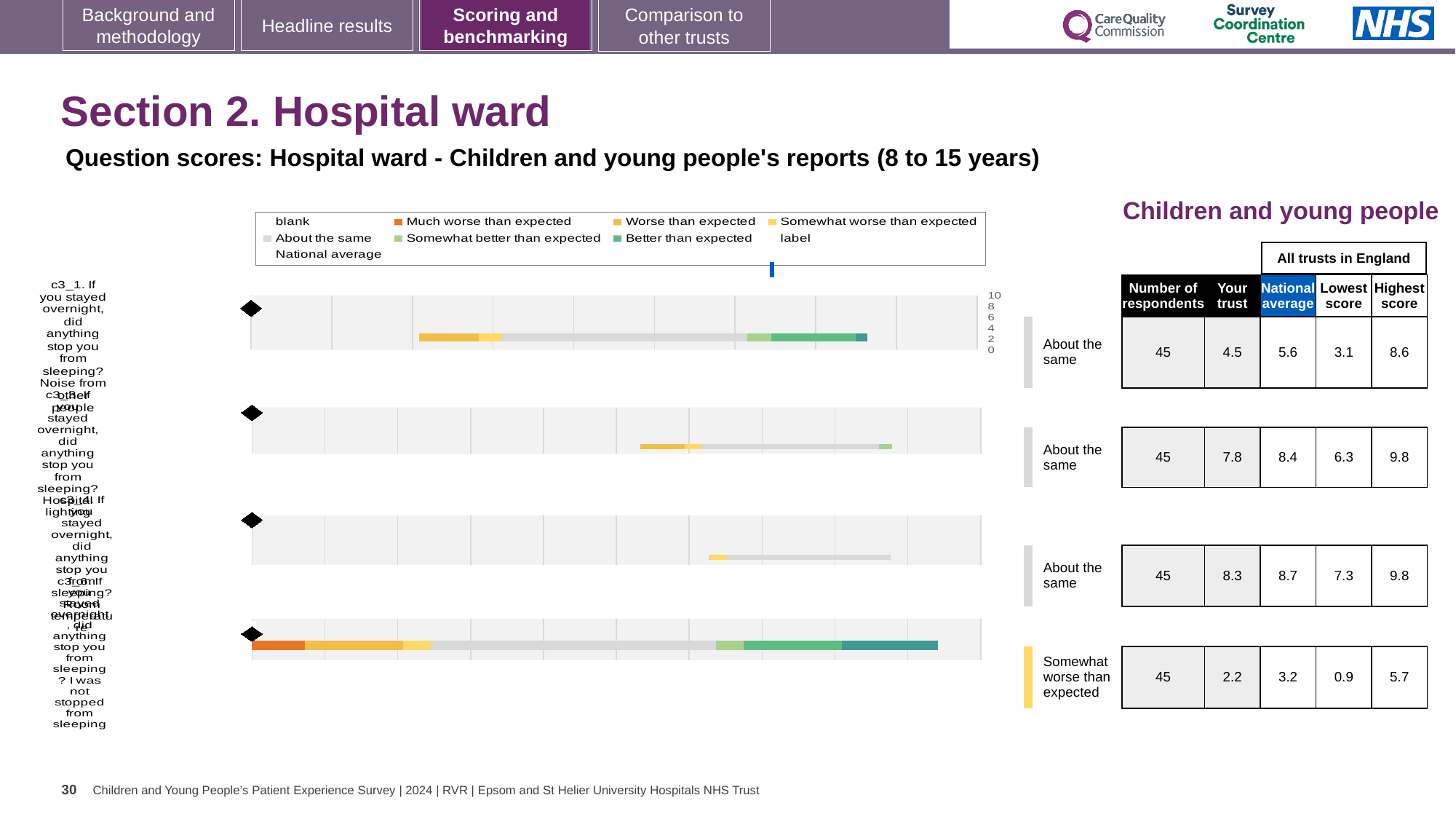
For the first (top) question row, how much higher is the national average than the 'Your trust' score? 1.1 Which question row has the highest 'Your trust' score? The third row (8.3) Which question row has the lowest 'Your trust' score? The fourth row (2.2) What colour represents 'Much worse than expected' in the legend? Orange What is the 'Your trust' score for the first (top) question row? 4.5 How many horizontal bars (question rows) does the chart show? 4 What kind of chart is shown on the slide? Bar chart How many entries does the chart legend list? 9 What is the national average for the fourth (bottom) question row? 3.2 What is the highest score across all trusts in England for the second question row? 9.8 What benchmark category is given for the fourth (bottom) question row? Somewhat worse than expected For the second question row, which is larger: the 'Your trust' score or the national average? National average (8.4)